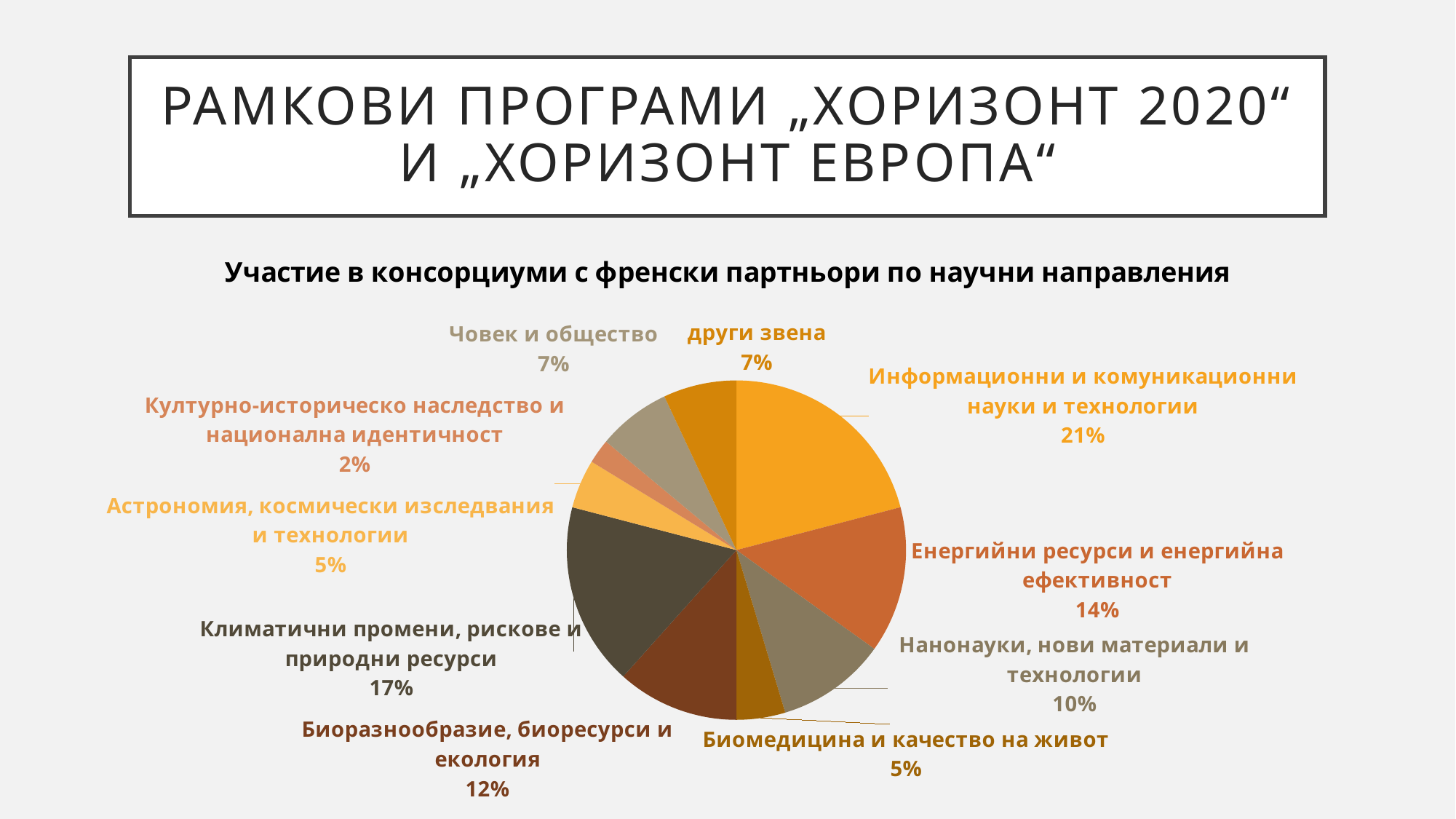
What is the difference in percentage points between 'Енергийни ресурси и енергийна ефективност' and 'Биоразнообразие, биоресурси и екология'? 2 What is the value shown for 'Биомедицина и качество на живот'? 5% What is the value shown for 'Климатични промени, рискове и природни ресурси'? 17% Which is larger: 'Климатични промени, рискове и природни ресурси' or 'Енергийни ресурси и енергийна ефективност'? Климатични промени, рискове и природни ресурси How many slices does the pie chart have? 10 What is the value shown for 'други звена'? 7% Which category has the largest share of the pie? Информационни и комуникационни науки и технологии What share of the pie is 'Информационни и комуникационни науки и технологии'? 21% Which category has the smallest share of the pie? Културно-историческо наследство и национална идентичност What kind of chart is shown on the slide? Pie chart What is the value shown for 'Нанонауки, нови материали и технологии'? 10% What is the title of the chart? Участие в консорциуми с френски партньори по научни направления